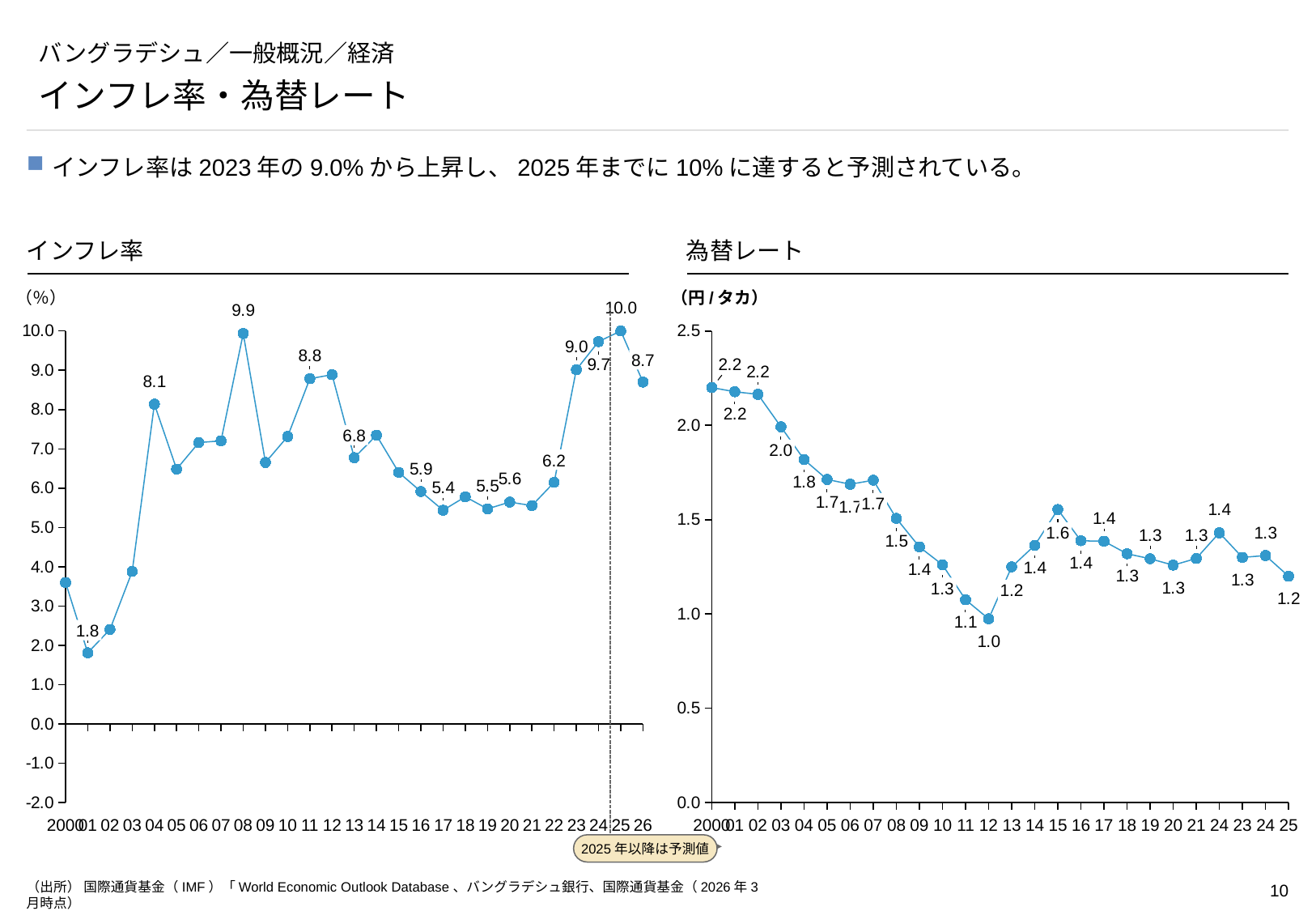
In the インフレ率 chart, what is the difference between the 2025 value and the 2023 value? 1.0 In the 為替レート chart, do the values rise or fall from 2000 to 2012? fall In the 為替レート chart, what is the difference between the 2000 value and the 2025 value? 1.0 In the インフレ率 chart, which year has the higher inflation rate, 2004 or 2011? 2011 In the インフレ率 chart, what is the inflation rate for 2008? 9.9 In the インフレ率 chart, is the value for 2000 greater or less than 3.0? greater In the 為替レート chart, what is the value for 2012? 1.0 In the 為替レート chart, which year has the lowest value? 2012 What kind of chart is the インフレ率 chart? line chart In the インフレ率 chart, which year has the highest inflation rate? 2025 In the インフレ率 chart, what is the forecast inflation rate for 2026? 8.7 In the インフレ率 chart, which year has the lowest inflation rate? 2001